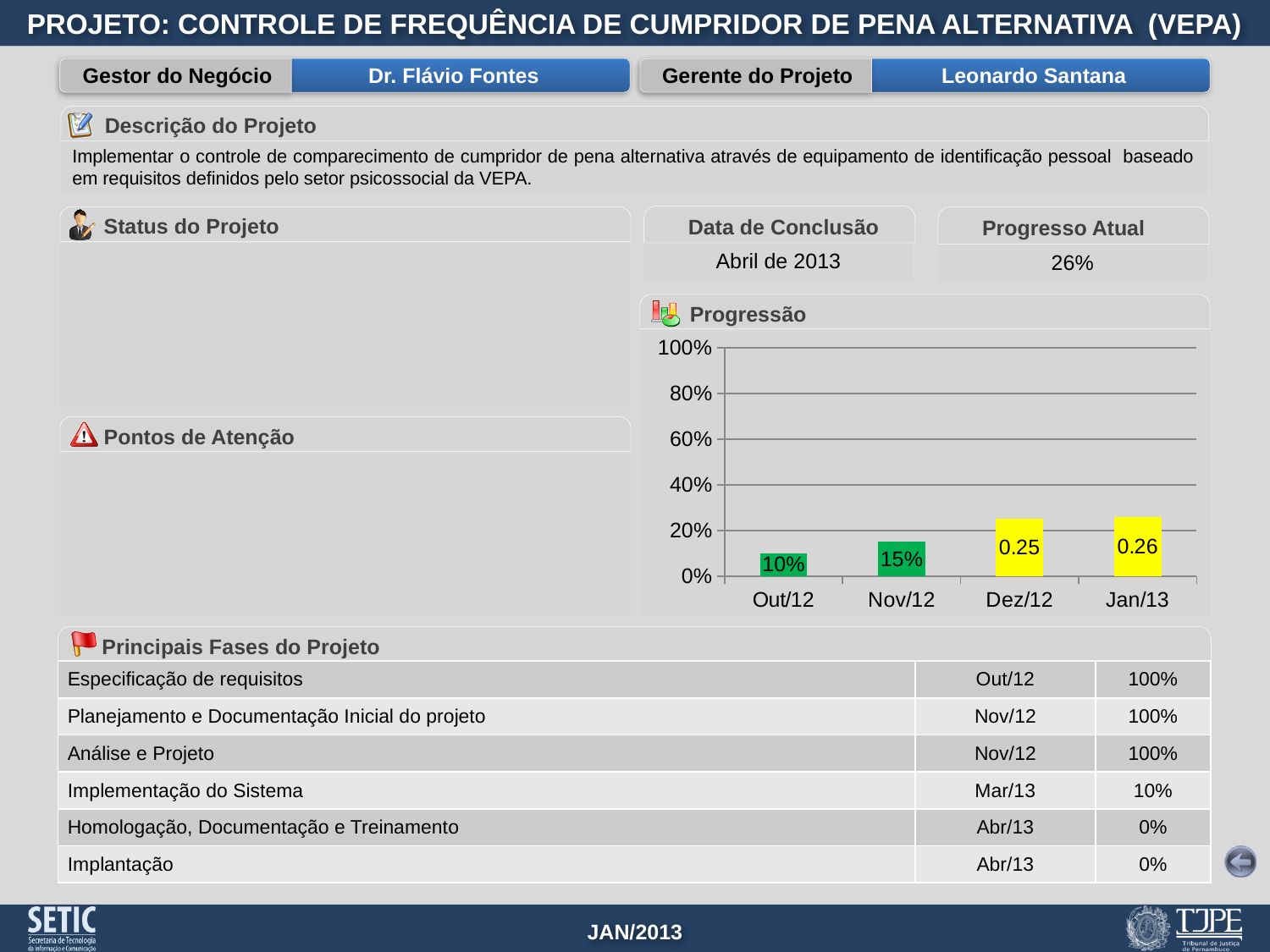
In the Progressão chart, which is larger, the value for Nov/12 or the value for Out/12? Nov/12 In the Progressão chart, which month has the highest value? Jan/13 How many months are plotted in the Progressão chart? 4 In the Progressão chart, what is the difference between the Nov/12 and Out/12 values? 5% In the Progressão chart, what is the data label on the Dez/12 bar? 0.25 In the Progressão chart, what is the value shown for Nov/12? 15% In the Progressão chart, which month has the lowest value? Out/12 In the Progressão chart, do the values rise or fall from Out/12 to Jan/13? rise In the Progressão chart, is the value for Jan/13 greater or less than 40%? less In the Progressão chart, what is the value shown for Out/12? 10% What kind of chart is the Progressão chart? bar chart In the Progressão chart, what is the data label on the Jan/13 bar? 0.26